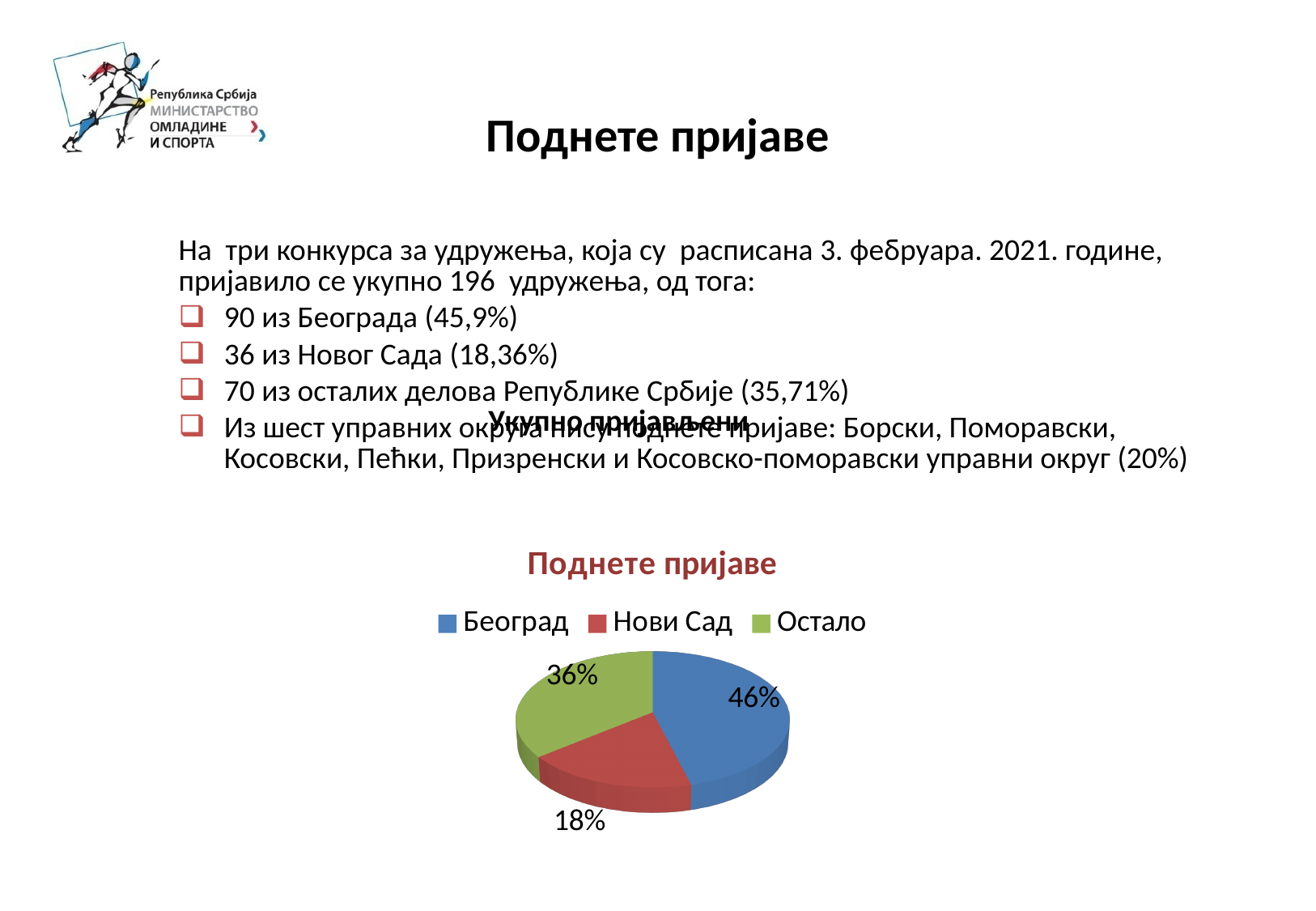
What type of chart is shown on the slide? pie chart Which slice is larger, Остало or Нови Сад? Остало How many entries does the chart legend list? 3 What percentage is shown for Остало in the pie chart? 36% What is the difference in percentage points between the Београд slice and the Нови Сад slice? 28 Which category has the largest slice of the pie chart? Београд What is the title of the chart? Поднете пријаве What percentage is shown for Београд in the pie chart? 46% What percentage is shown for Нови Сад in the pie chart? 18% How many slices does the pie chart have? 3 Which category has the smallest slice of the pie chart? Нови Сад Which colour represents Остало in the pie chart? green